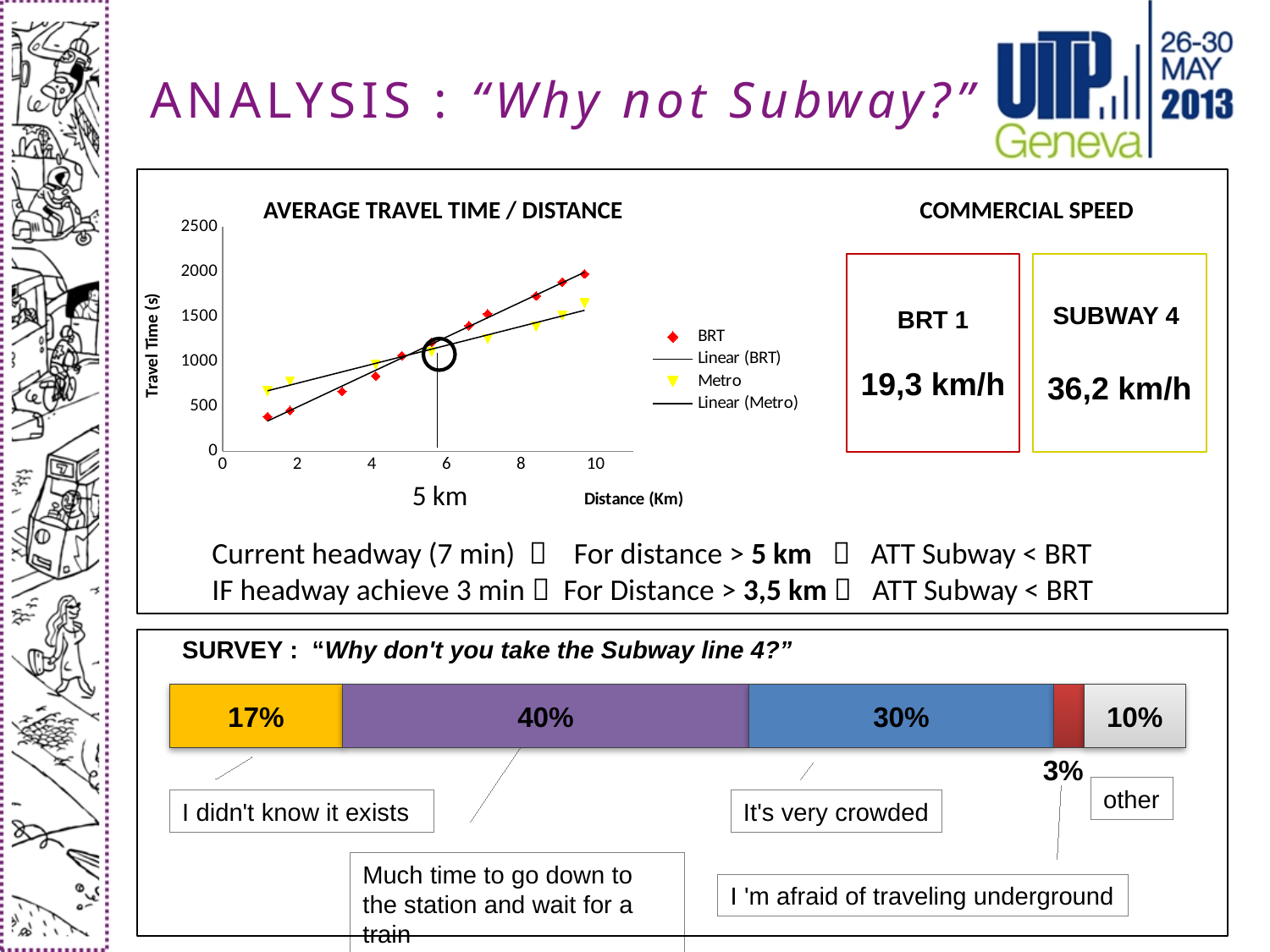
In the survey chart "Why don't you take the Subway line 4?", what share of respondents said "It's very crowded"? 30% In the survey chart "Why don't you take the Subway line 4?", what share of respondents said "I didn't know it exists"? 17% What kind of chart is the AVERAGE TRAVEL TIME / DISTANCE chart? scatter chart In the AVERAGE TRAVEL TIME / DISTANCE chart, is the BRT travel time at the farthest plotted distance greater or less than 1500? greater In the AVERAGE TRAVEL TIME / DISTANCE chart, at about 2 km, which series has the higher travel time, BRT or Metro? Metro In the AVERAGE TRAVEL TIME / DISTANCE chart, how many entries does the legend list? 4 In the AVERAGE TRAVEL TIME / DISTANCE chart, do the BRT travel times rise or fall as distance increases? rise In the survey chart "Why don't you take the Subway line 4?", which reason has the largest share? Much time to go down to the station and wait for a train In the survey chart "Why don't you take the Subway line 4?", what is the difference between the largest share and the "It's very crowded" share? 10% How many segments does the survey bar "Why don't you take the Subway line 4?" contain? 5 In the AVERAGE TRAVEL TIME / DISTANCE chart, at about 10 km, which series has the higher travel time, BRT or Metro? BRT What is the label of the vertical axis in the AVERAGE TRAVEL TIME / DISTANCE chart? Travel Time (s)